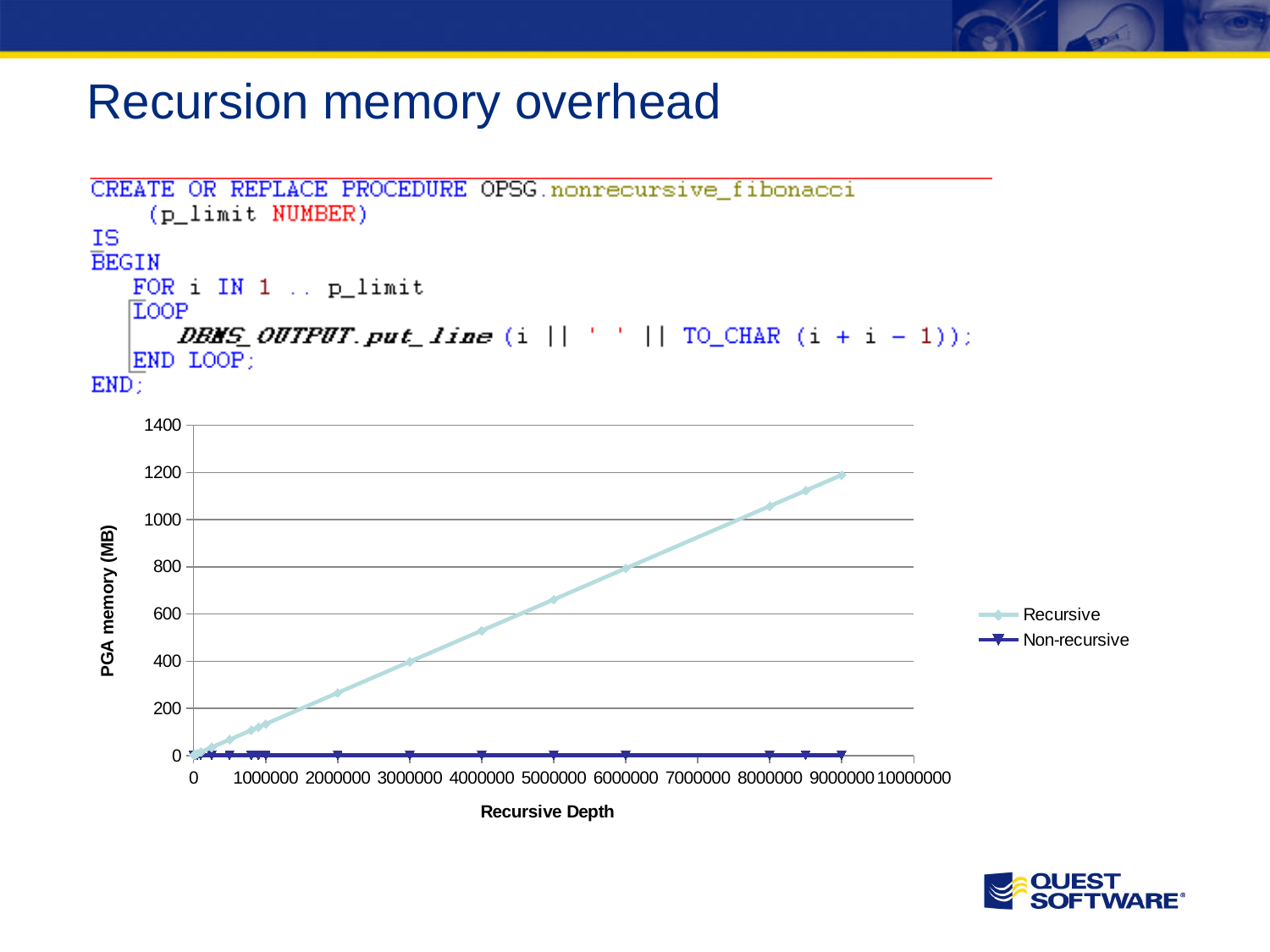
Is the PGA memory for the Recursive series at a recursive depth of 9000000 greater or less than 1000? greater Which series uses more PGA memory at a recursive depth of 9000000, Recursive or Non-recursive? Recursive Does the Recursive series rise or fall as Recursive Depth increases? rise Which series has the highest PGA memory value on the chart? Recursive What kind of chart is shown on the slide? line chart What is the highest value shown on the chart's y axis? 1400 What is the label of the chart's y axis? PGA memory (MB) How many series does the chart legend list? 2 Is the PGA memory for the Recursive series at a recursive depth of 6000000 greater or less than 600? greater Is the PGA memory for the Non-recursive series at a recursive depth of 9000000 greater or less than 200? less What are the two series named in the chart legend? Recursive and Non-recursive